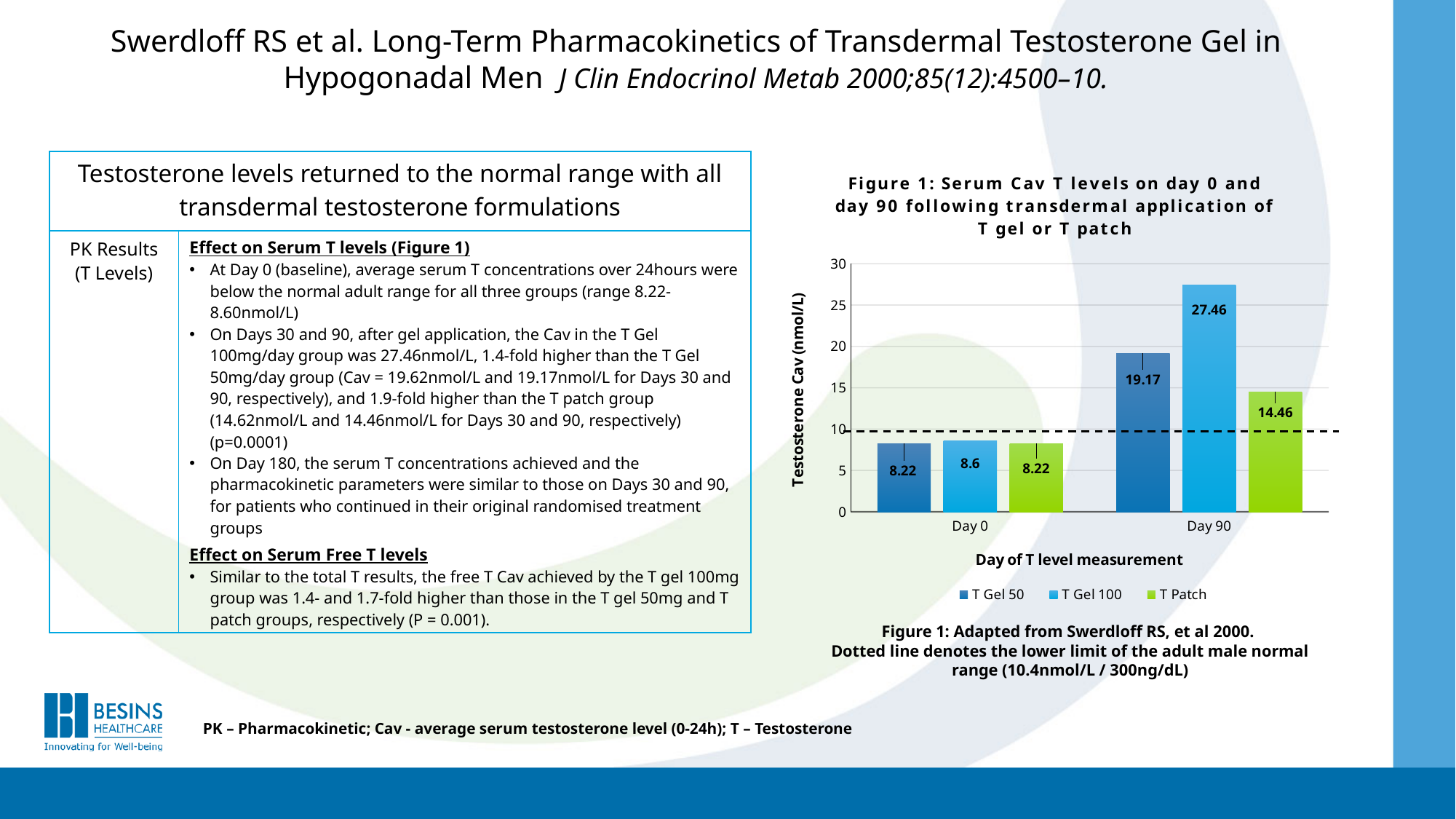
Is the value for T Gel 100 on Day 90 greater or less than 25? greater How many series does the legend list? 3 What kind of chart is shown? Bar chart What is the value for T Gel 100 on Day 90? 27.46 Which series has the highest value on Day 90? T Gel 100 How many categories are shown on the x axis? 2 What is the label of the y axis? Testosterone Cav (nmol/L) What is the value for T Gel 50 on Day 90? 19.17 Which is larger: the T Gel 50 value on Day 90 or the T Patch value on Day 90? T Gel 50 on Day 90 Which series has the lowest value on Day 90? T Patch What is the difference between the T Gel 100 and T Gel 50 values on Day 90? 8.29 What is the value for T Patch on Day 0? 8.22